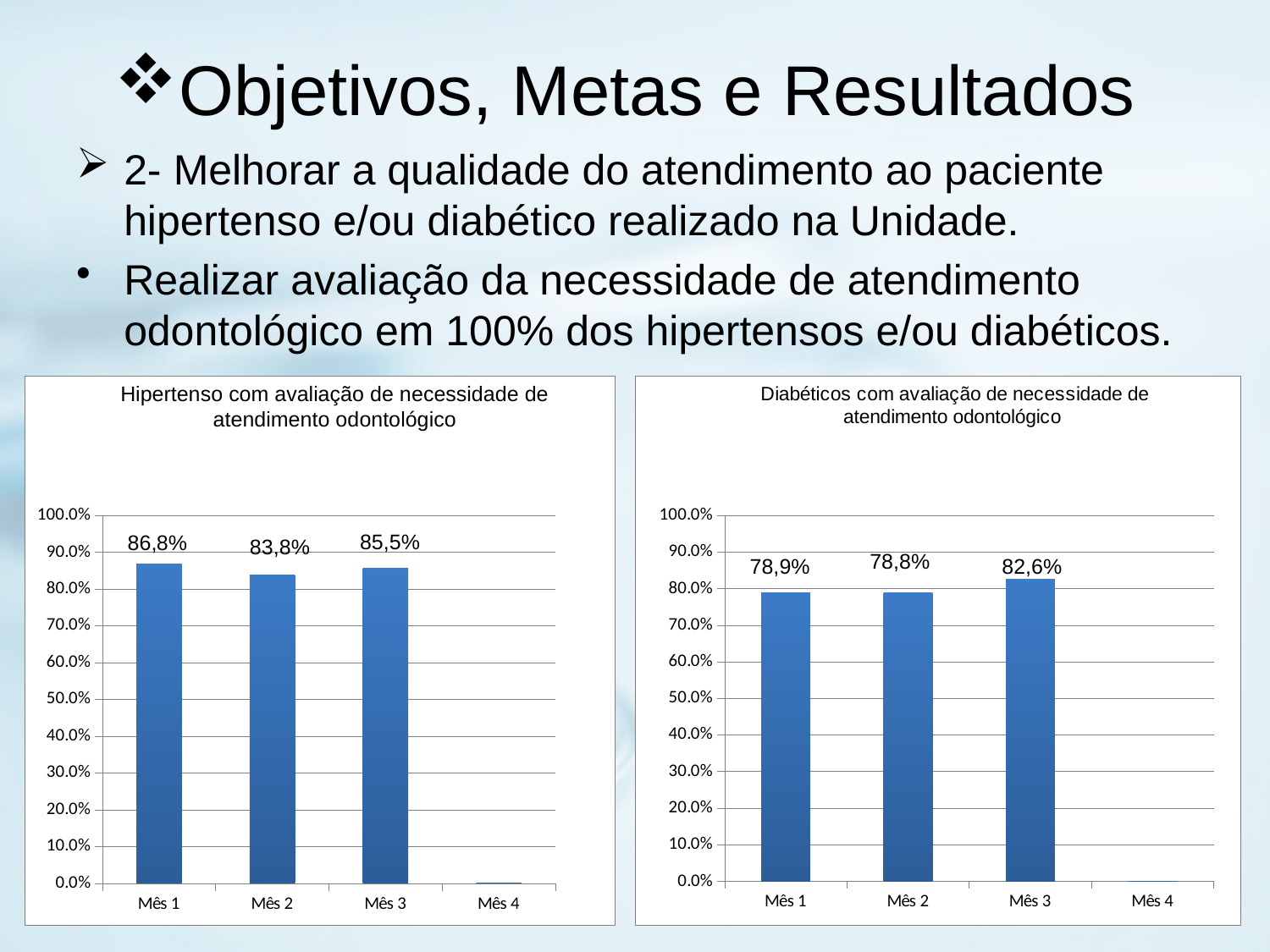
In the chart titled "Diabéticos com avaliação de necessidade de atendimento odontológico", what is the value for Mês 1? 78,9% In the chart titled "Diabéticos com avaliação de necessidade de atendimento odontológico", what is the value for Mês 3? 82,6% In the right chart (Diabéticos), is the value for Mês 2 greater or less than 80.0%? less In the right chart (Diabéticos), what is the difference between the values for Mês 3 and Mês 1? 3,7 percentage points What kind of chart is the right chart (Diabéticos)? Bar chart In the left chart (Hipertenso), which month has the highest value? Mês 1 In the left chart (Hipertenso), what is the difference between the values for Mês 1 and Mês 2? 3,0 percentage points In the chart titled "Hipertenso com avaliação de necessidade de atendimento odontológico", what is the value for Mês 1? 86,8% In the chart titled "Hipertenso com avaliação de necessidade de atendimento odontológico", what is the value for Mês 2? 83,8% In the right chart (Diabéticos), which month has the highest value? Mês 3 In the left chart (Hipertenso), which is larger, the value for Mês 3 or the value for Mês 2? Mês 3 How many categories are shown on the x axis of the left chart (Hipertenso)? 4